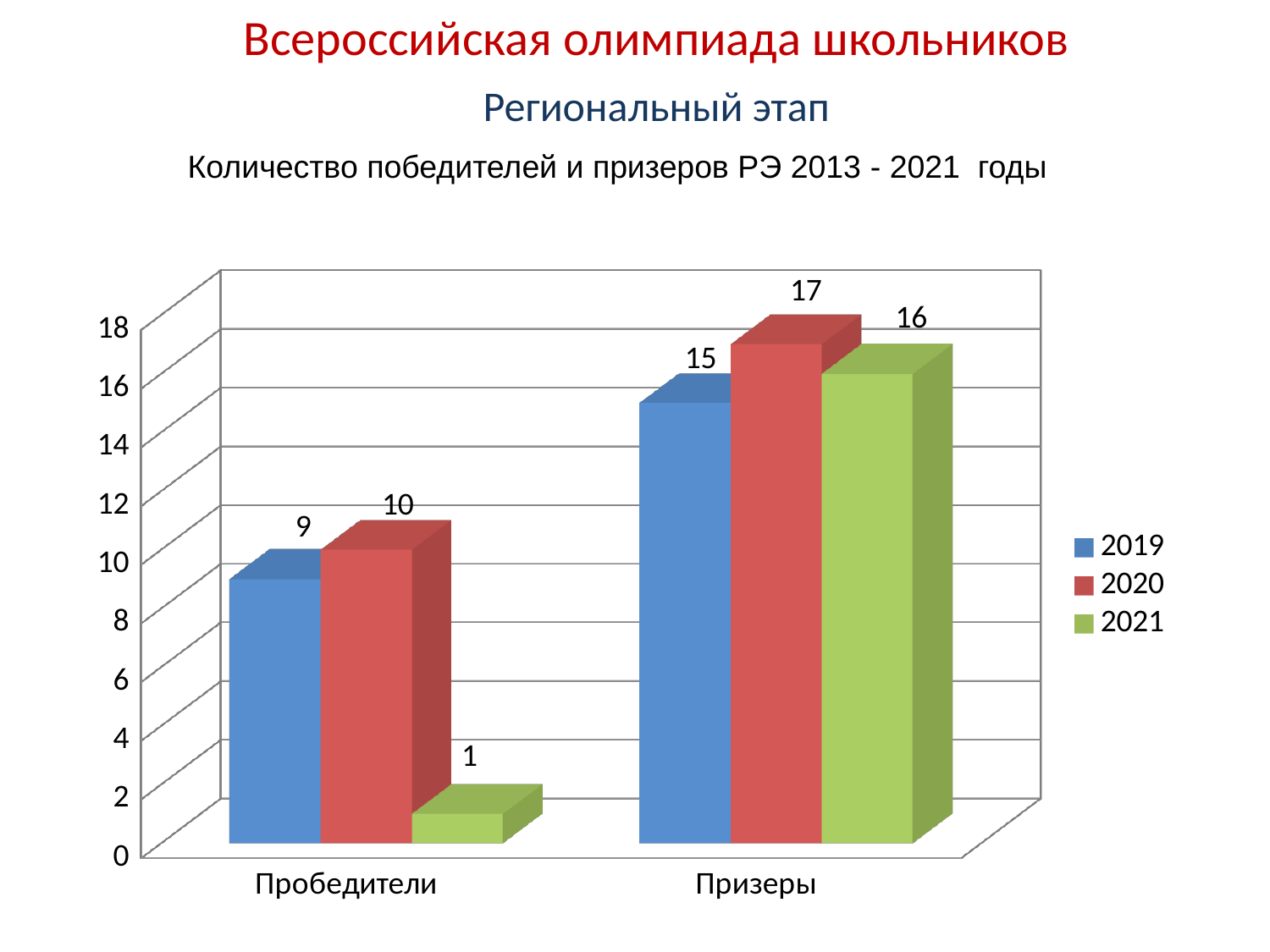
What is the value for 2019 in the Пробедители category? 9 What is the difference between the 2020 and 2021 values in the Пробедители category? 9 What is the value for 2020 in the Пробедители category? 10 What is the value for 2021 in the Призеры category? 16 What kind of chart is shown on the slide? Bar chart What is the difference between the 2020 and 2019 values in the Призеры category? 2 Which colour represents the 2021 series in the legend? Green Which year has the lowest value in the Пробедители category? 2021 Which year has the highest value in the Призеры category? 2020 Which is larger: the 2019 value for Призеры or the 2020 value for Пробедители? 2019 value for Призеры How many series does the legend list? 3 How many categories are shown on the x axis? 2